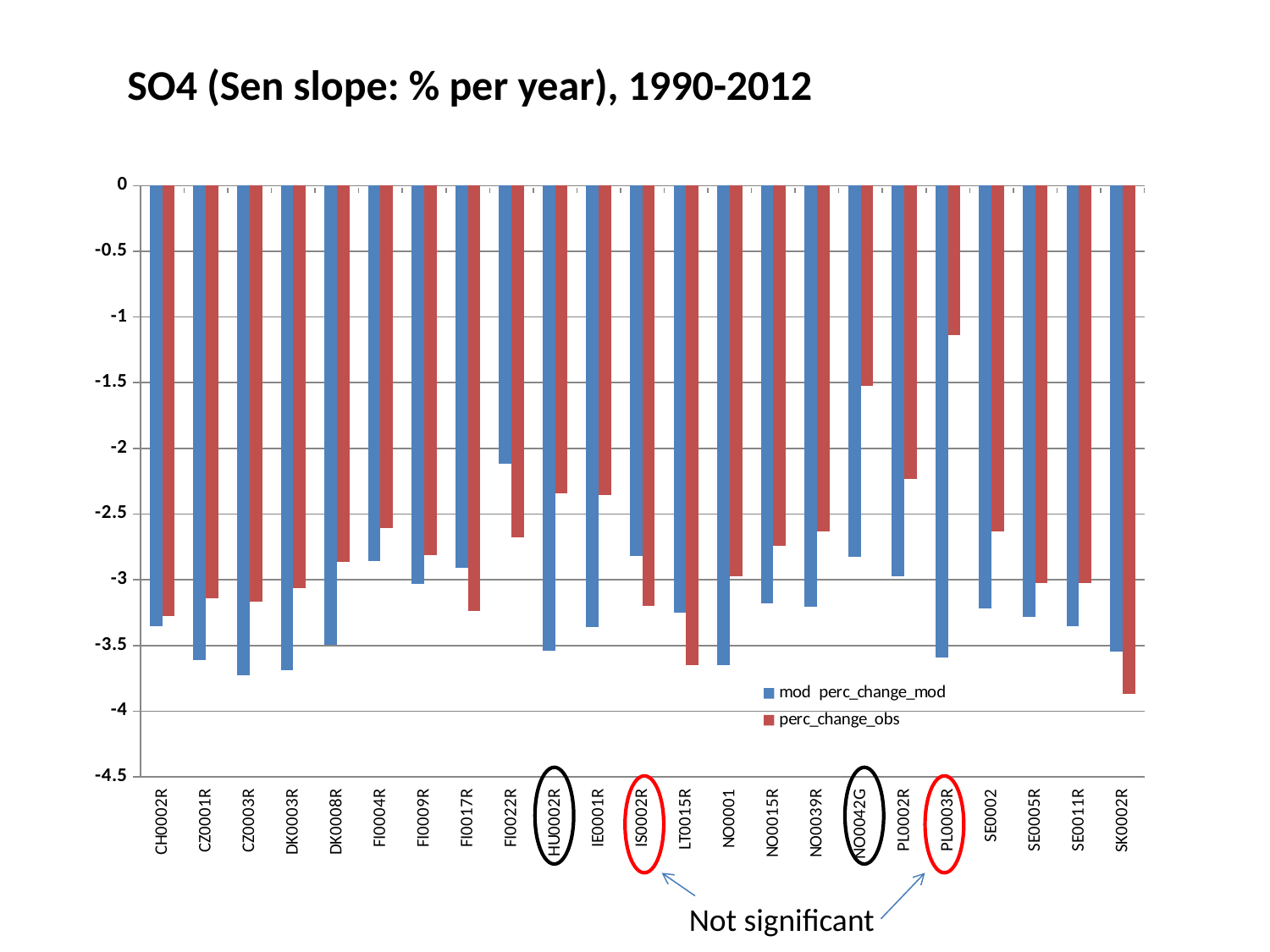
How many series does the legend list? 2 What is the title of the chart? SO4 (Sen slope: % per year), 1990-2012 Is the perc_change_obs value for SK0002R greater or less than -3.5? less Which two stations are marked with red circles as 'Not significant'? IS0002R and PL0003R How many stations (categories) are shown on the x axis? 23 Is the mod perc_change_mod value for FI0022R greater or less than -2.5? greater Is the perc_change_obs value for PL0003R greater or less than -2? greater Which station has the most negative perc_change_obs value? SK0002R Which station has the least negative mod perc_change_mod value? FI0022R What kind of chart is shown on the slide? bar chart Which station has the least negative perc_change_obs value? PL0003R For PL0003R, which series has the more negative value? mod perc_change_mod